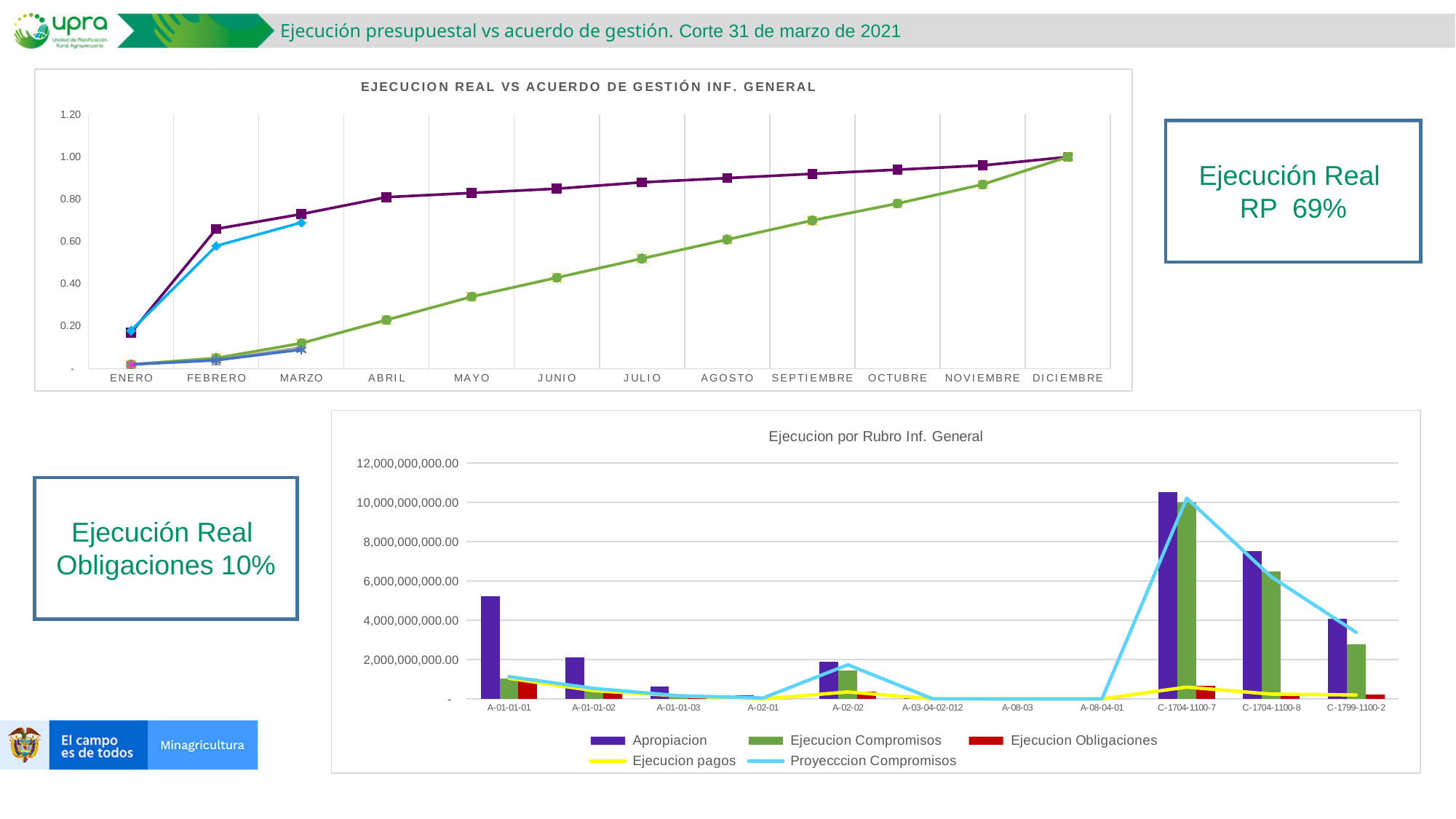
In the top chart 'EJECUCION REAL VS ACUERDO DE GESTIÓN INF. GENERAL', how many months are shown on the x axis? 12 In the bottom chart 'Ejecucion por Rubro Inf. General', how many rubro categories are shown on the x axis? 11 In the top chart 'EJECUCION REAL VS ACUERDO DE GESTIÓN INF. GENERAL', is the value of the green line for ABRIL greater or less than 0.20? greater In the bottom chart 'Ejecucion por Rubro Inf. General', is the Apropiacion value for A-01-01-01 greater or less than 4,000,000,000.00? greater In the top chart 'EJECUCION REAL VS ACUERDO DE GESTIÓN INF. GENERAL', does the purple line rise or fall from ENERO to DICIEMBRE? rise In the bottom chart 'Ejecucion por Rubro Inf. General', which category has the highest Apropiacion bar? C-1704-1100-7 What kind of chart is the top chart titled 'EJECUCION REAL VS ACUERDO DE GESTIÓN INF. GENERAL'? line chart What kind of chart is the bottom chart titled 'Ejecucion por Rubro Inf. General'? combination bar and line chart In the bottom chart 'Ejecucion por Rubro Inf. General', which series is shown in red in the legend? Ejecucion Obligaciones In the top chart 'EJECUCION REAL VS ACUERDO DE GESTIÓN INF. GENERAL', is the value of the purple line for FEBRERO greater or less than 0.60? greater In the bottom chart 'Ejecucion por Rubro Inf. General', how many series does the legend list? 5